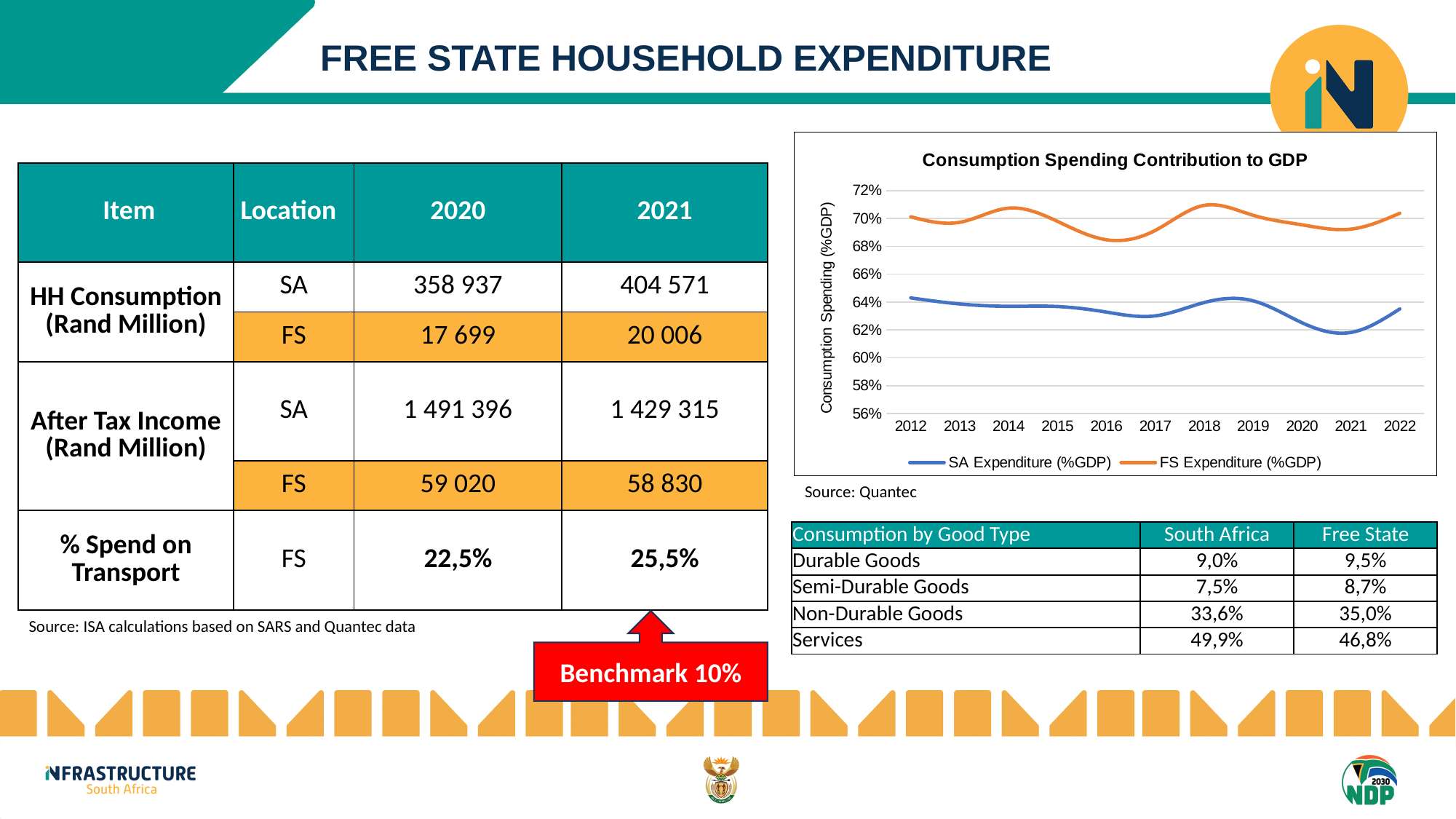
In the "Consumption Spending Contribution to GDP" chart, which series is plotted in orange? FS Expenditure (%GDP) In the "Consumption Spending Contribution to GDP" chart, is the value for SA Expenditure (%GDP) in 2012 greater or less than 64%? greater What kind of chart is "Consumption Spending Contribution to GDP"? line chart In the "Consumption Spending Contribution to GDP" chart, is the value for SA Expenditure (%GDP) in 2021 greater or less than 62%? less How many series does the legend of the "Consumption Spending Contribution to GDP" chart list? 2 In the "Consumption Spending Contribution to GDP" chart, in which year is FS Expenditure (%GDP) at its lowest? 2016 In the "Consumption Spending Contribution to GDP" chart, is the value for FS Expenditure (%GDP) in 2016 greater or less than 70%? less How many years are shown on the x axis of the "Consumption Spending Contribution to GDP" chart? 11 In the "Consumption Spending Contribution to GDP" chart, does SA Expenditure (%GDP) rise or fall from 2019 to 2021? fall In the "Consumption Spending Contribution to GDP" chart, in which year is SA Expenditure (%GDP) at its lowest? 2021 In the "Consumption Spending Contribution to GDP" chart, which series is higher in 2018, SA Expenditure (%GDP) or FS Expenditure (%GDP)? FS Expenditure (%GDP)